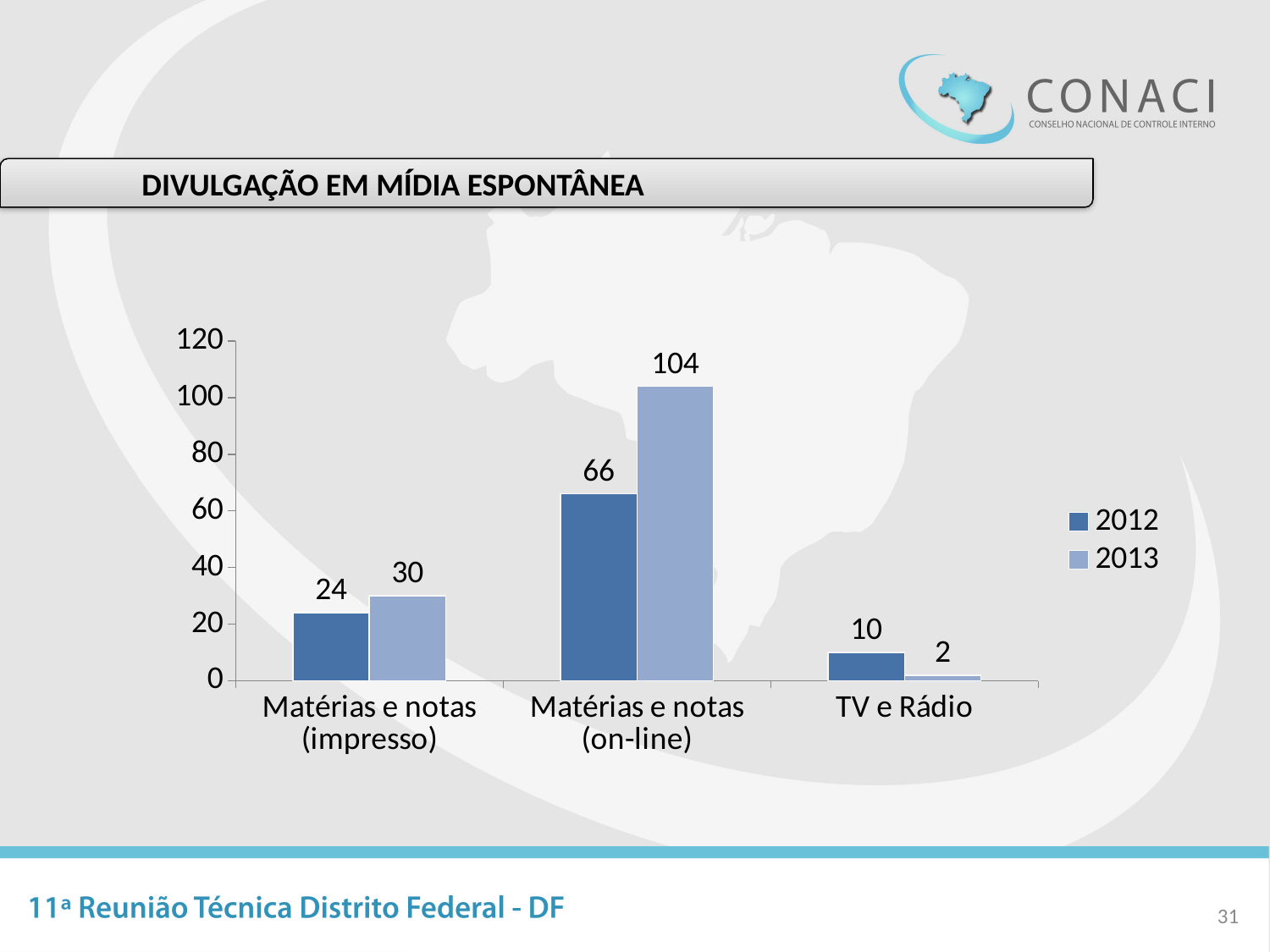
What is the title shown above the chart? DIVULGAÇÃO EM MÍDIA ESPONTÂNEA How many categories are shown on the x axis? 3 Which category has the lowest 2013 value? TV e Rádio What is the difference between the 2013 and 2012 values for Matérias e notas (on-line)? 38 What kind of chart is shown on the slide? bar chart Which is larger for TV e Rádio, the 2012 value or the 2013 value? 2012 Which category has the highest 2012 value? Matérias e notas (on-line) What is the 2013 value for Matérias e notas (on-line)? 104 What is the 2012 value for Matérias e notas (impresso)? 24 How many series does the legend list? 2 Is the 2012 value for Matérias e notas (on-line) greater or less than 60? greater What is the 2013 value for TV e Rádio? 2